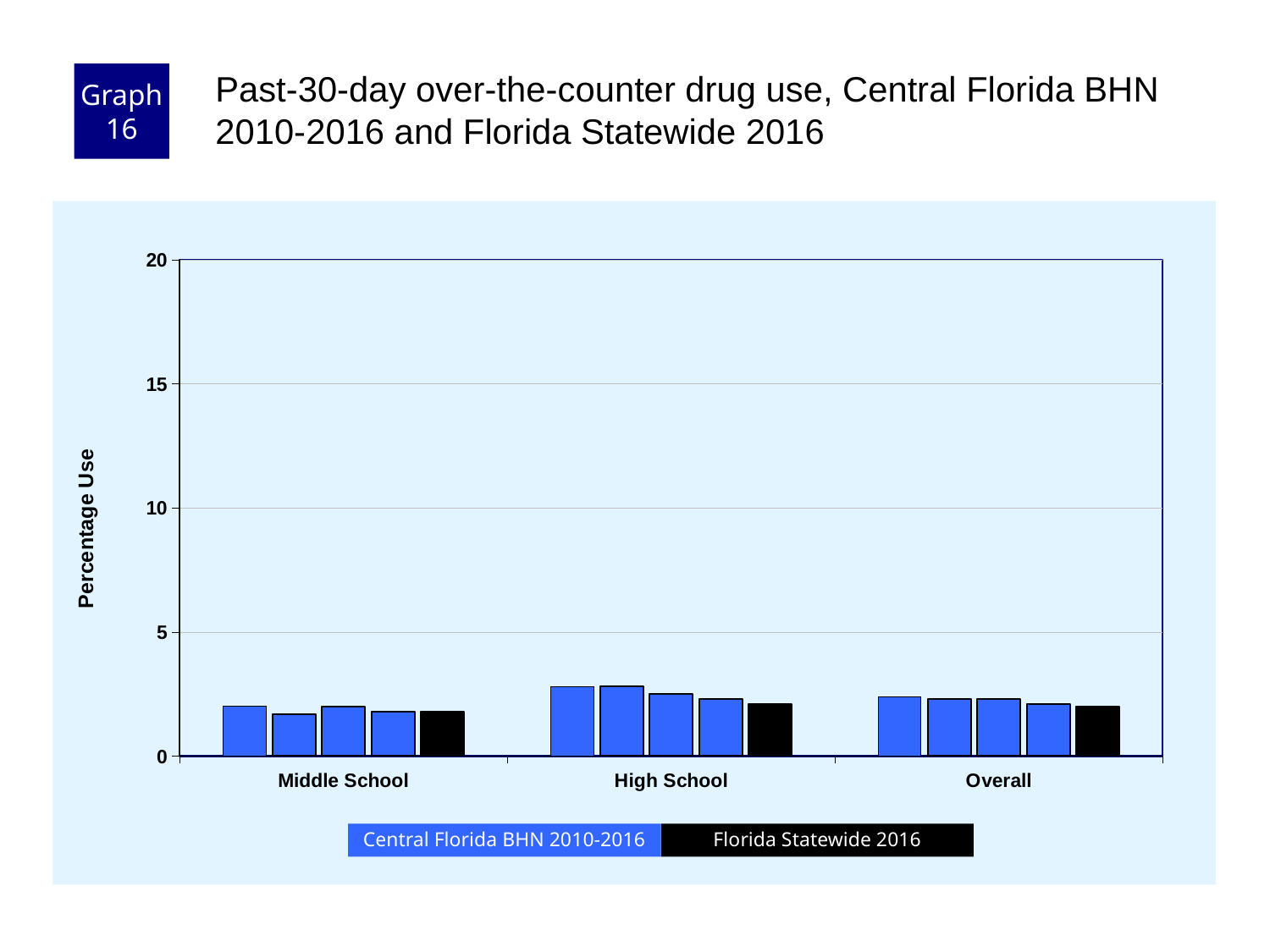
Which colour represents Florida Statewide 2016 in the legend? black Which category has the tallest bar in the chart? High School Is the Florida Statewide 2016 value for Overall greater or less than 10? less What is the label on the vertical axis? Percentage Use What kind of chart is shown on the slide? bar chart How many categories are shown on the x axis? 3 Is the Florida Statewide 2016 value for High School greater or less than 5? less Is the Florida Statewide 2016 value for Middle School greater or less than 5? less Which is larger: the tallest Central Florida BHN bar for High School or the tallest Central Florida BHN bar for Middle School? High School How many series does the legend list? 2